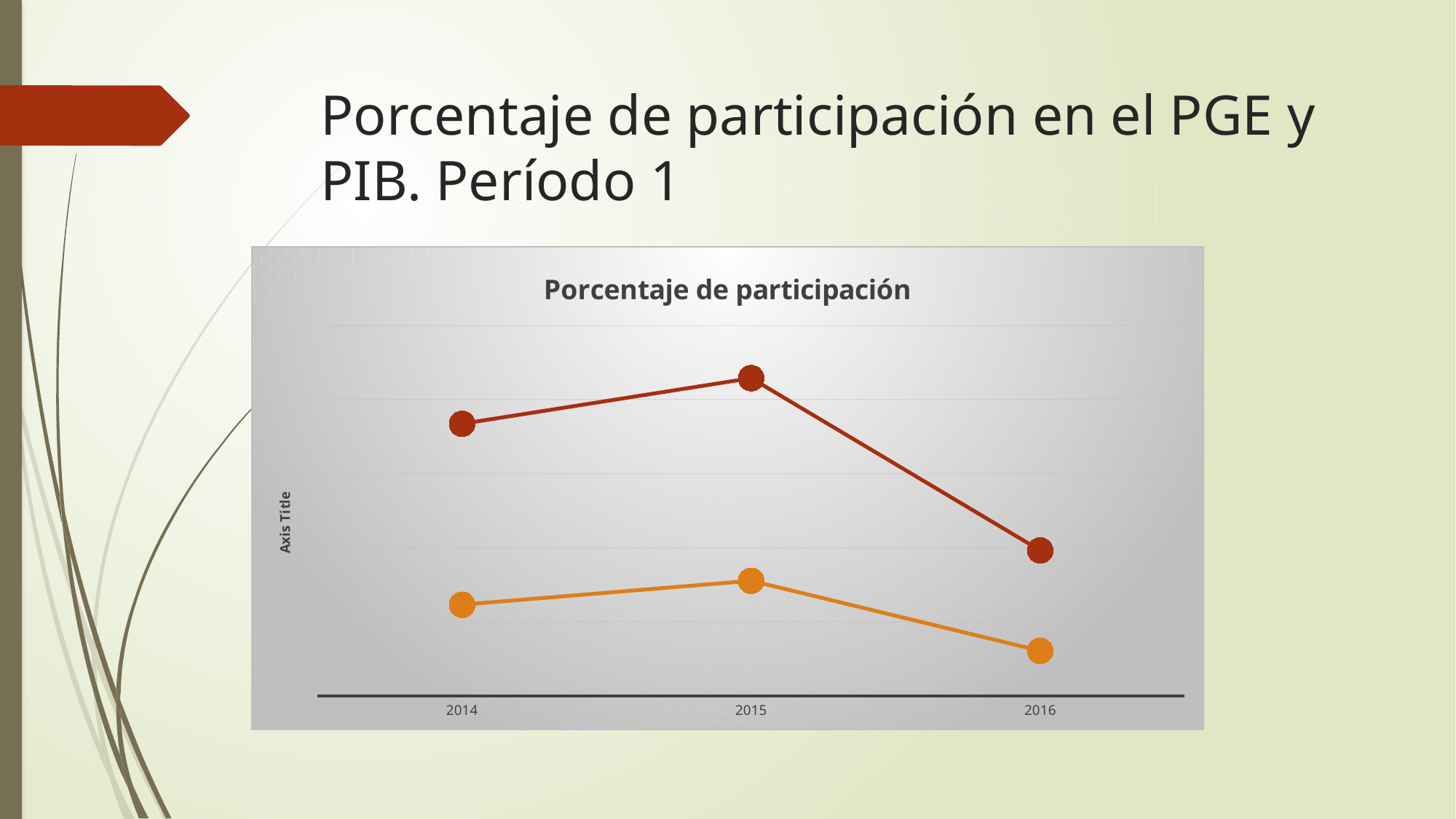
Does the orange line rise or fall between 2014 and 2015? Rise How many years are shown on the x axis of the chart? 3 In which year does the orange line reach its lowest point? 2016 Does the dark red line rise or fall between 2015 and 2016? Fall In which year does the dark red line reach its highest point? 2015 In which year does the dark red line reach its lowest point? 2016 In which year does the orange line reach its highest point? 2015 In 2016, which line has the higher value, the dark red line or the orange line? The dark red line How many lines are plotted in the chart? 2 What kind of chart is shown on the slide? Line chart Which years are shown on the x axis of the chart? 2014, 2015, 2016 What is the title of the chart? Porcentaje de participación